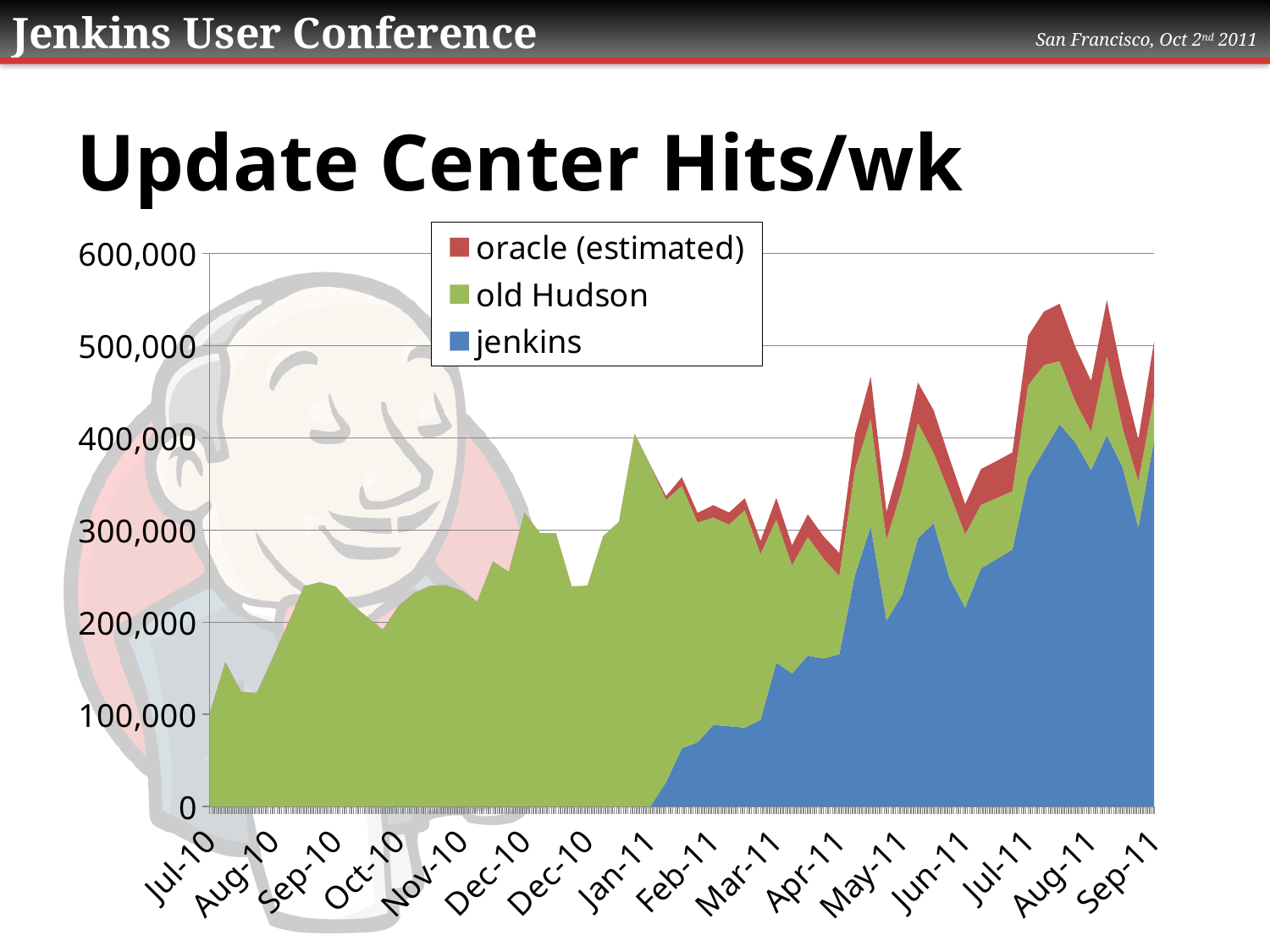
Does the jenkins series rise or fall from Jan-11 to Sep-11? rise Does the old Hudson series rise or fall from Jan-11 to Sep-11? fall What kind of chart is shown on the slide? Stacked area chart How many month labels are shown along the x axis? 16 What is the highest value shown on the y axis? 600,000 Which series is shown in green in the legend? old Hudson Is the jenkins value at Sep-11 greater or less than 300,000? greater What is the title of the chart? Update Center Hits/wk Is the highest point of the stacked total greater or less than 500,000? greater How many series does the legend list? 3 Is the total value at Jul-10 greater or less than 200,000? less